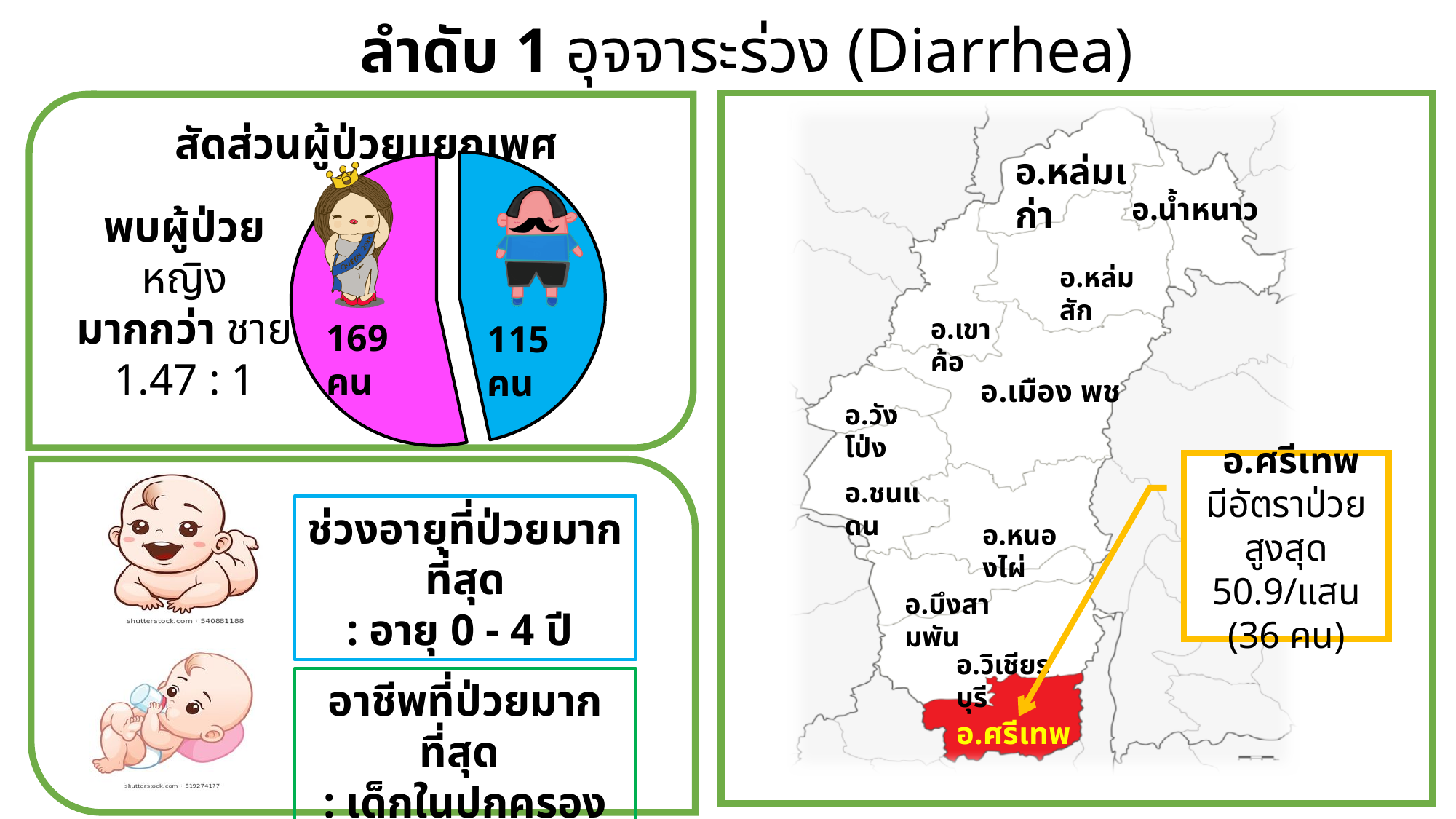
In the pie chart, how many patients are male (ชาย)? 115 คน Which slice of the pie chart is larger, female (หญิง) or male (ชาย)? หญิง What is the total number of patients represented in the pie chart? 284 In the pie chart, how many patients are female (หญิง)? 169 คน Which slice of the pie chart is smaller, female (หญิง) or male (ชาย)? ชาย What is the female-to-male ratio of patients stated next to the pie chart? 1.47 : 1 What is the difference between the number of female and male patients in the pie chart? 54 Is the number of female patients in the pie chart greater or less than the number of male patients? greater What kind of chart is shown in the top-left panel of the slide? pie chart How many slices does the pie chart have? 2 What colour is the female (หญิง) slice of the pie chart? pink (magenta)